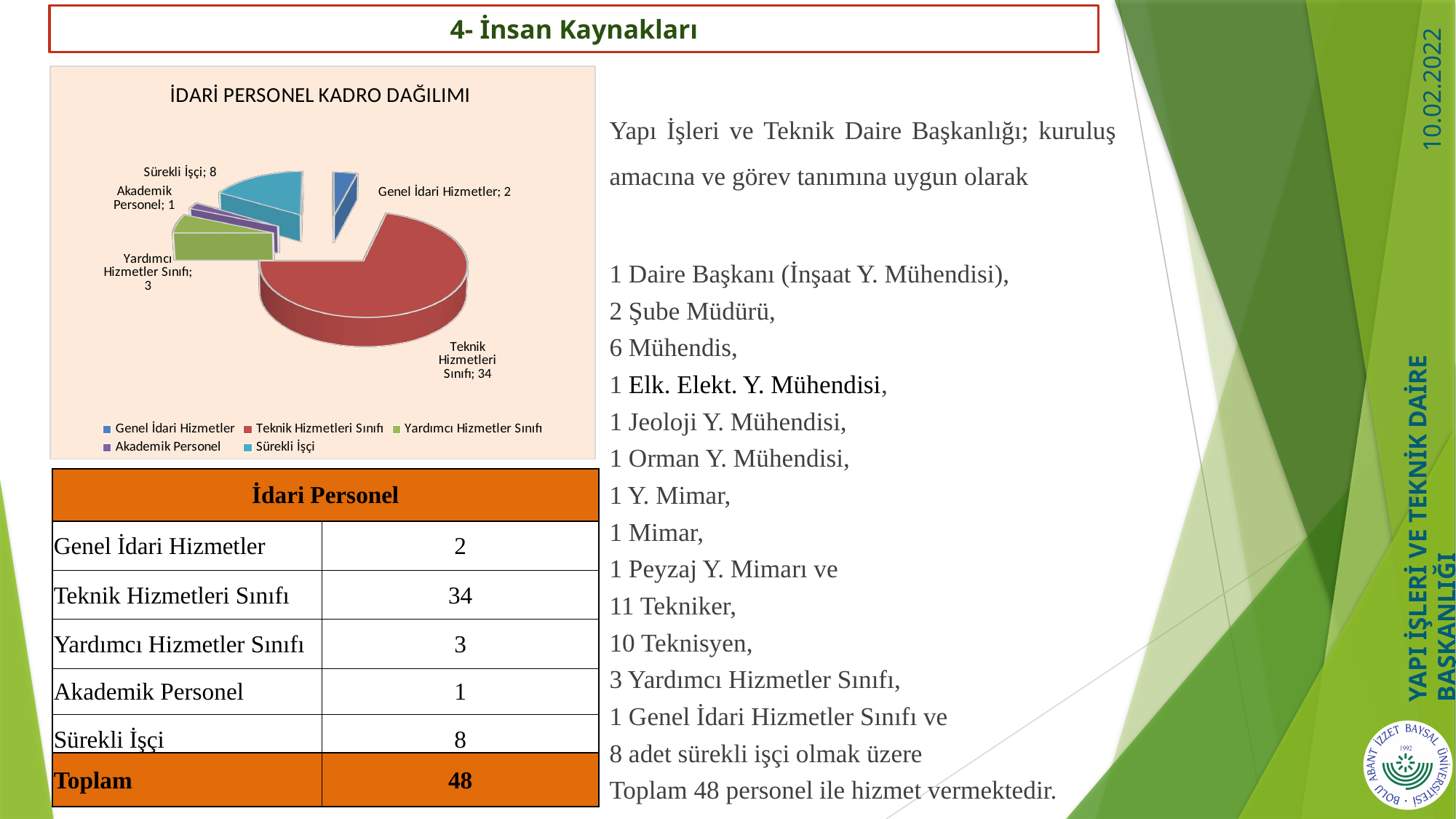
What is the value for Akademik Personel in the pie chart? 1 What is the value for Yardımcı Hizmetler Sınıfı in the pie chart? 3 What is the difference between the values for Teknik Hizmetleri Sınıfı and Sürekli İşçi? 26 Which category has the largest slice in the pie chart? Teknik Hizmetleri Sınıfı What is the value for Teknik Hizmetleri Sınıfı in the pie chart? 34 How many categories does the pie chart show? 5 Which is larger in the pie chart: Genel İdari Hizmetler or Yardımcı Hizmetler Sınıfı? Yardımcı Hizmetler Sınıfı What kind of chart is shown on the slide? Pie chart What is the total of all the values shown in the pie chart? 48 What is the value for Sürekli İşçi in the pie chart? 8 What is the title of the chart? İDARİ PERSONEL KADRO DAĞILIMI Which category has the smallest slice in the pie chart? Akademik Personel